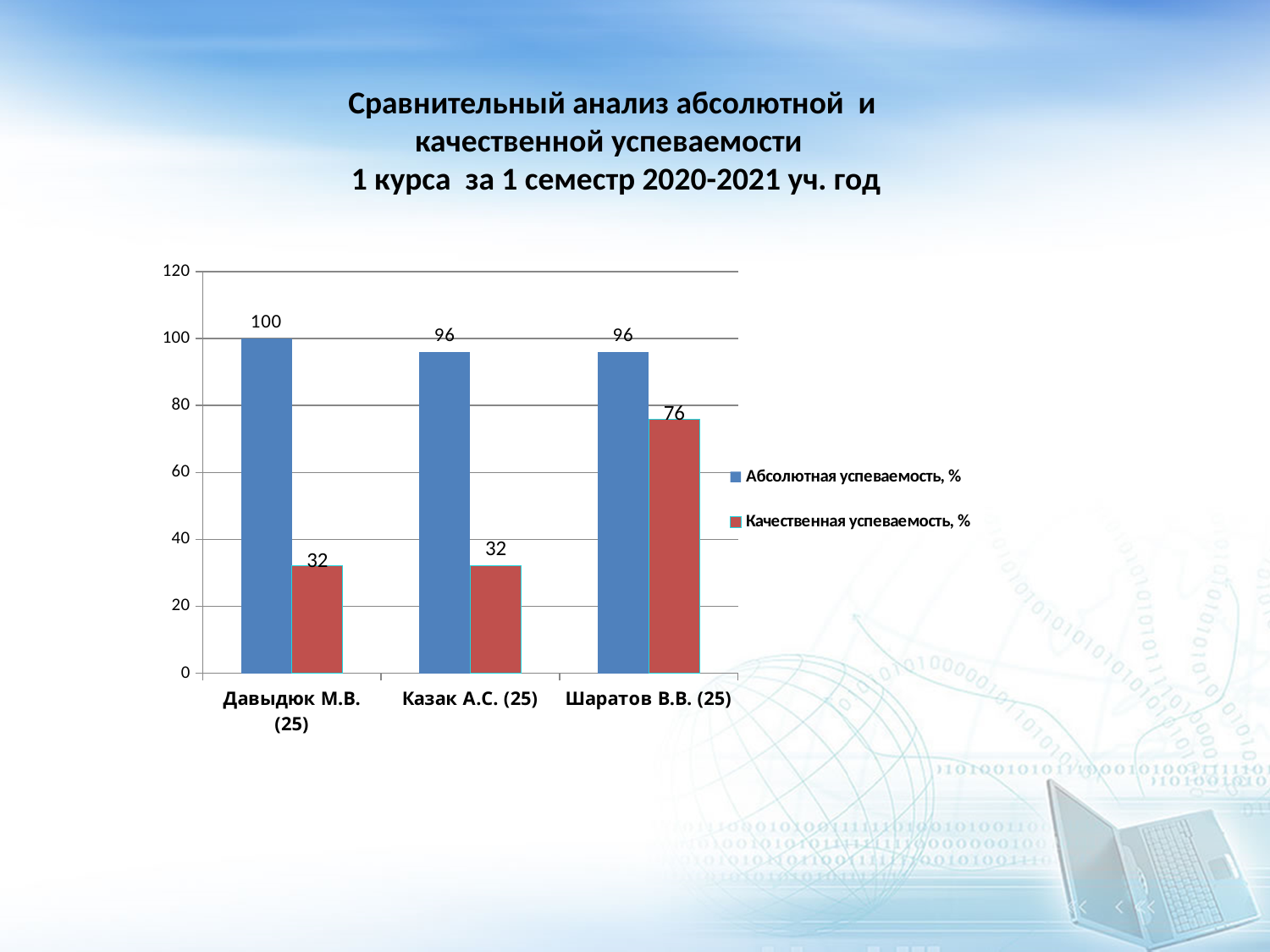
What kind of chart is shown on the slide? bar chart What is the difference between Абсолютная успеваемость, % and Качественная успеваемость, % for Давыдюк М.В. (25)? 68 What is the value of Качественная успеваемость, % for Шаратов В.В. (25)? 76 How many categories are shown on the x axis? 3 What is the value of Абсолютная успеваемость, % for Давыдюк М.В. (25)? 100 Which category has the highest Абсолютная успеваемость, %? Давыдюк М.В. (25) What is the value of Качественная успеваемость, % for Казак А.С. (25)? 32 What is the difference in Качественная успеваемость, % between Шаратов В.В. (25) and Казак А.С. (25)? 44 Which colour represents Абсолютная успеваемость, % in the chart? blue How many series does the legend list? 2 Which is larger: Качественная успеваемость, % for Шаратов В.В. (25) or for Давыдюк М.В. (25)? Шаратов В.В. (25) Which category has the highest Качественная успеваемость, %? Шаратов В.В. (25)